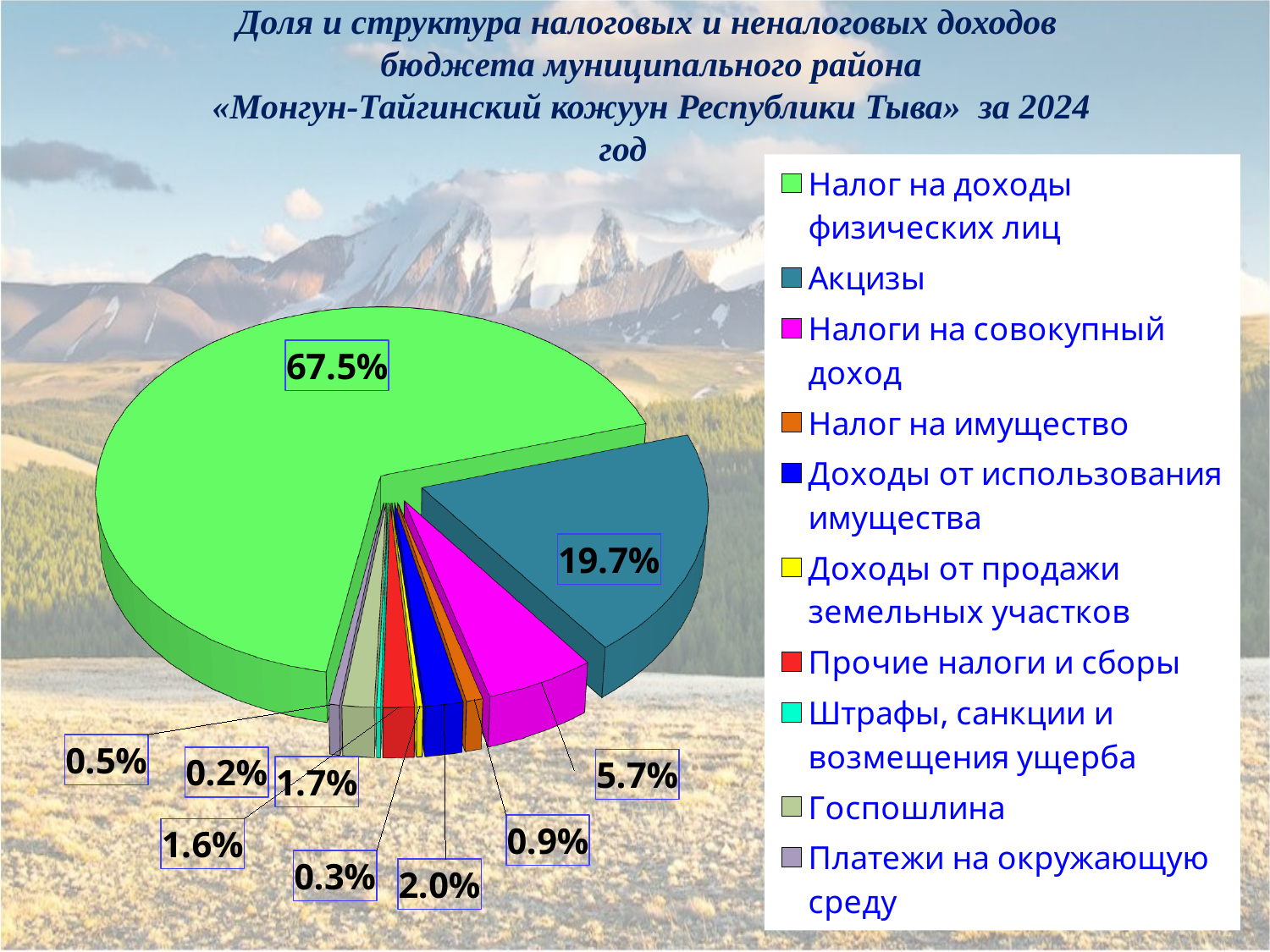
For which year does the chart show the budget revenue structure? 2024 What percentage is shown for «Налог на имущество»? 0.9% What percentage is shown for «Акцизы»? 19.7% Which category has the largest slice of the pie? Налог на доходы физических лиц What share of the pie does «Налог на доходы физических лиц» have? 67.5% What kind of chart is shown on the slide? Pie chart What percentage is shown for «Доходы от использования имущества»? 2.0% What percentage is shown for «Налоги на совокупный доход»? 5.7% How many categories does the legend list? 10 What is the smallest percentage labelled on the pie? 0.2% Which is larger: the share of «Акцизы» or the share of «Налоги на совокупный доход»? Акцизы By how many percentage points does «Налог на доходы физических лиц» exceed «Акцизы»? 47.8 percentage points